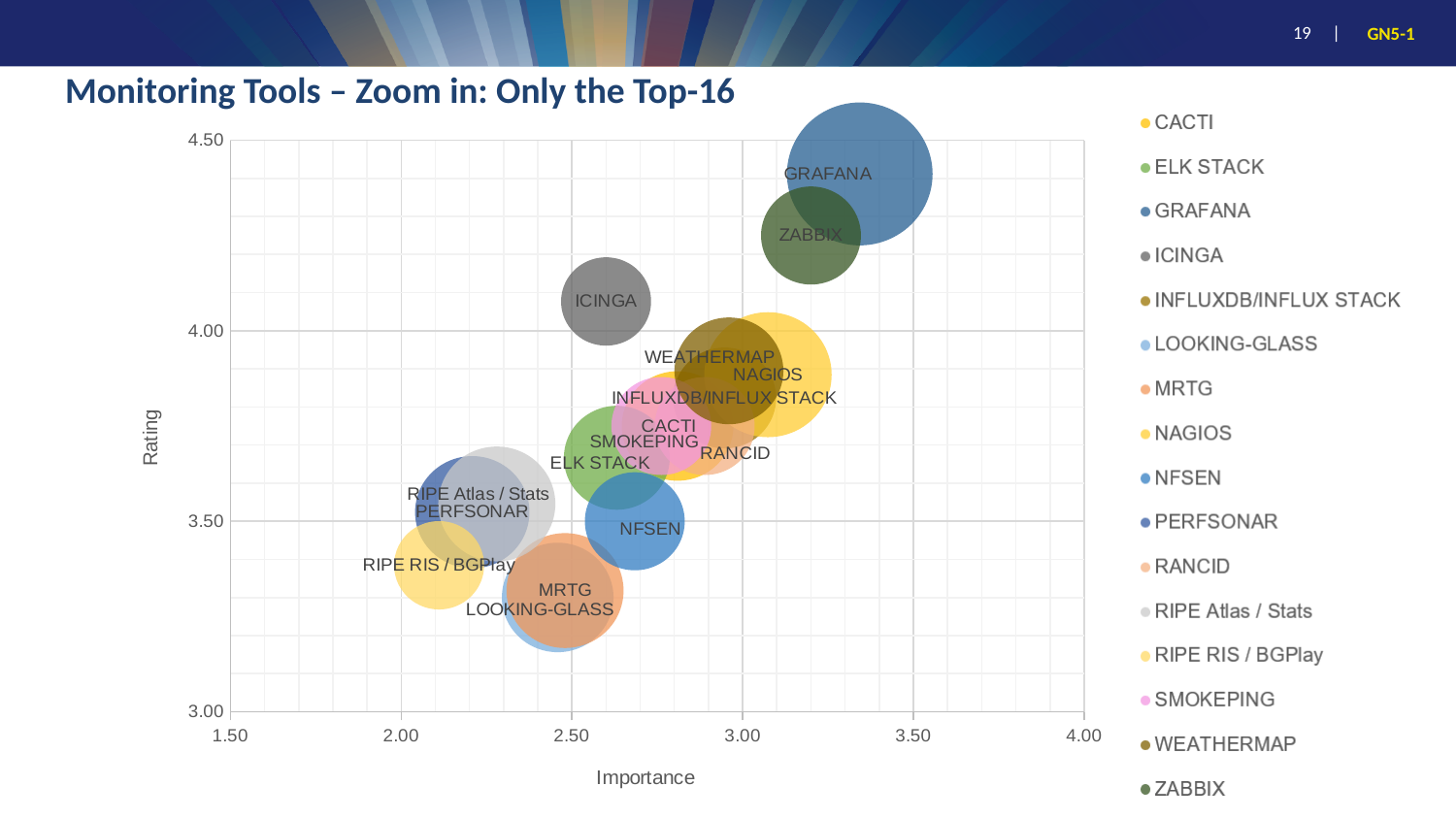
Which has the higher Rating, GRAFANA or ICINGA? GRAFANA How many series does the legend list? 16 Is the Importance for ZABBIX greater or less than 3.00? greater Which tool has the highest Importance? GRAFANA What kind of chart is shown on the slide? bubble chart What is the label of the vertical axis? Rating Is the Rating for MRTG greater or less than 3.50? less Which tool has the lowest Importance? RIPE RIS / BGPlay Which has the higher Importance, ZABBIX or MRTG? ZABBIX Is the Rating for GRAFANA greater or less than 4.00? greater What is the title of the chart? Monitoring Tools – Zoom in: Only the Top-16 Which tool has the highest Rating? GRAFANA